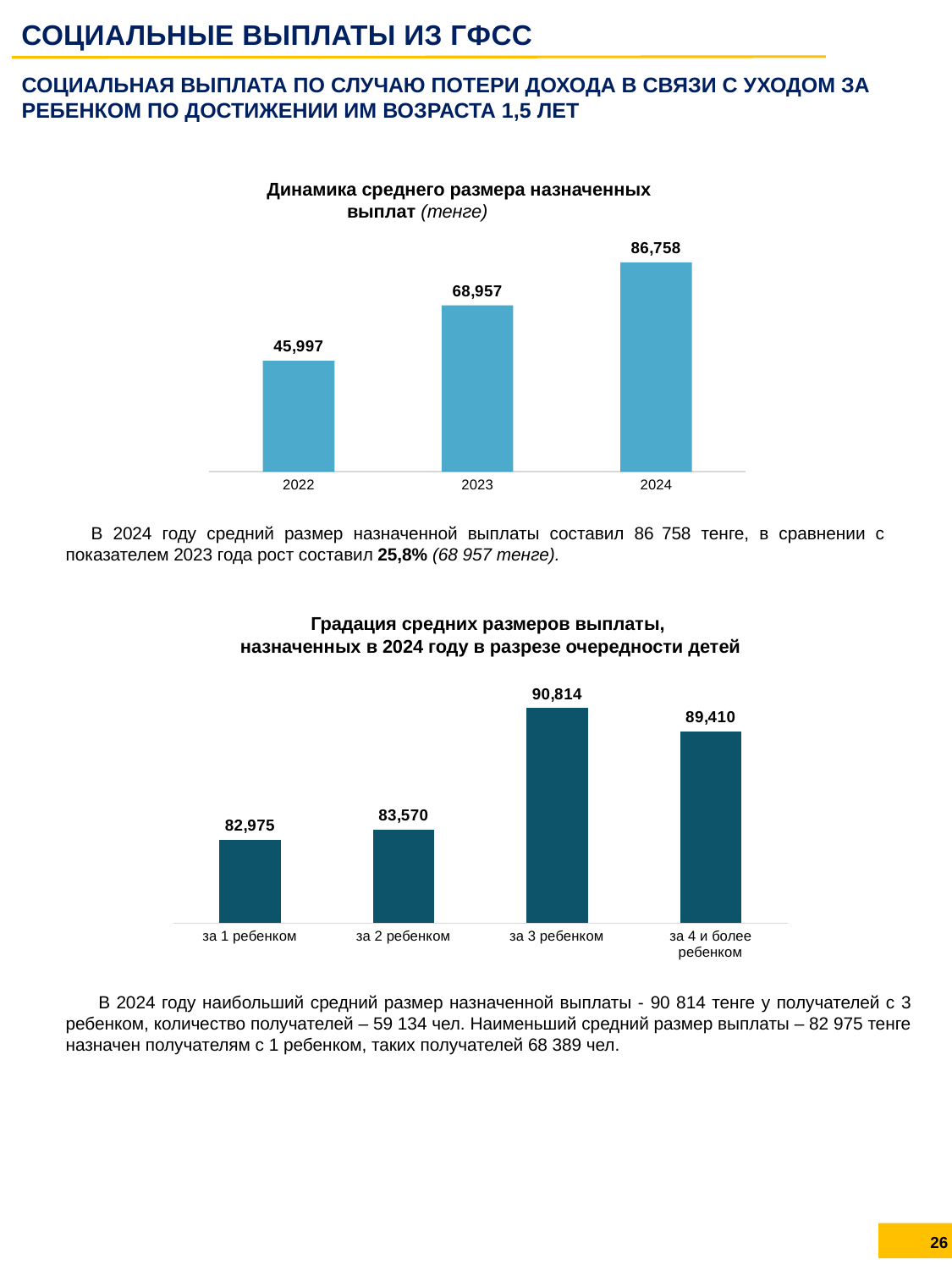
In the bottom chart (Градация средних размеров выплаты), what is the difference between 'за 3 ребенком' and 'за 1 ребенком'? 7,839 In the top chart (Динамика среднего размера назначенных выплат), what is the value for 2022? 45,997 What type of chart is the bottom chart (Градация средних размеров выплаты)? bar chart In the bottom chart (Градация средних размеров выплаты), which category has the highest value? за 3 ребенком In the top chart (Динамика среднего размера назначенных выплат), what is the difference between the 2024 and 2023 values? 17,801 In the bottom chart (Градация средних размеров выплаты), which is larger: the value for 'за 3 ребенком' or 'за 4 и более ребенком'? за 3 ребенком How many bars are shown in the top chart (Динамика среднего размера назначенных выплат)? 3 In the top chart (Динамика среднего размера назначенных выплат), do the values rise or fall from 2022 to 2024? rise In the bottom chart (Градация средних размеров выплаты), which category has the lowest value? за 1 ребенком In the top chart (Динамика среднего размера назначенных выплат), what is the value for 2024? 86,758 In the bottom chart (Градация средних размеров выплаты), what is the value for 'за 2 ребенком'? 83,570 In the top chart (Динамика среднего размера назначенных выплат), which year has the lowest value? 2022